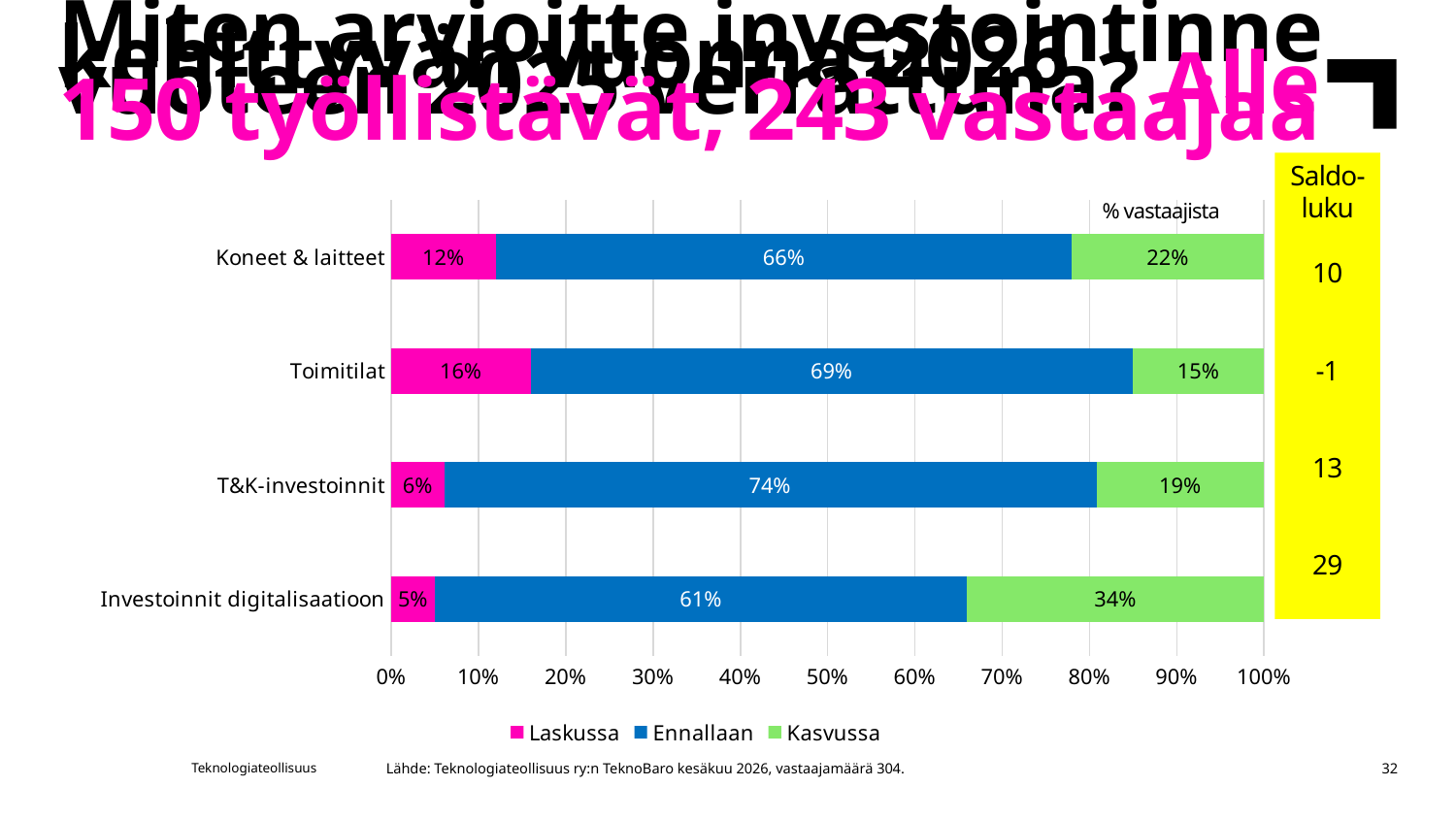
What is the Kasvussa value for Toimitilat? 15% Which is larger, the Laskussa value for Toimitilat or the Laskussa value for Koneet & laitteet? Toimitilat What percentage of respondents answered Laskussa for Koneet & laitteet? 12% What is the Kasvussa value for Investoinnit digitalisaatioon? 34% What is the difference between the Ennallaan values for T&K-investoinnit and Investoinnit digitalisaatioon? 13% What kind of chart is shown on the slide? Stacked bar chart How many series does the legend list? 3 Which category has the highest Kasvussa share? Investoinnit digitalisaatioon Which series is shown in blue in the legend? Ennallaan How many categories are shown on the chart? 4 Which category has the lowest Laskussa share? Investoinnit digitalisaatioon What is the Ennallaan value for T&K-investoinnit? 74%